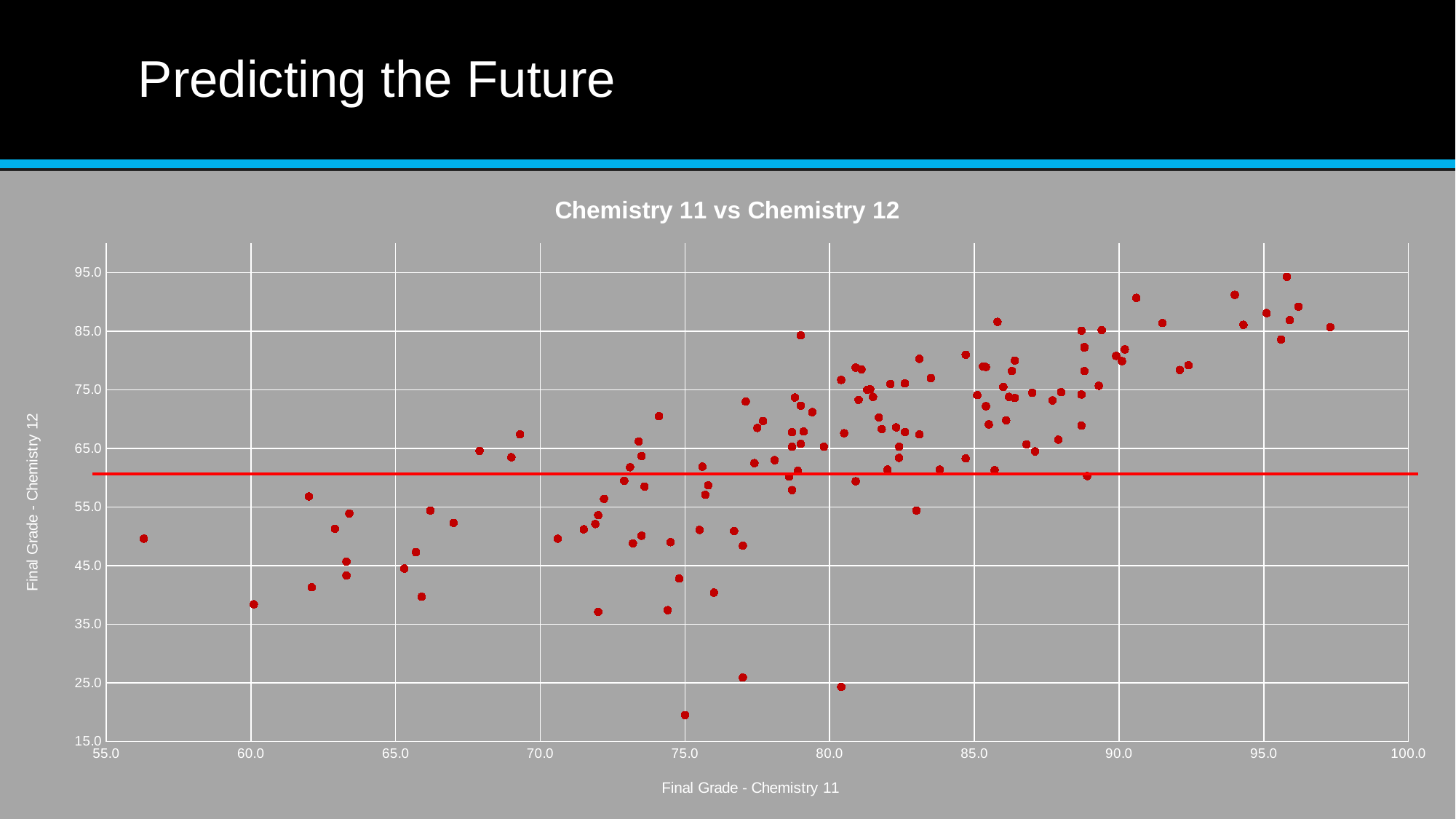
Is the Chemistry 12 grade of the rightmost plotted point greater or less than 75.0? greater Which has the higher Chemistry 12 grade, the leftmost plotted point or the rightmost plotted point? the rightmost plotted point What is the title of the chart? Chemistry 11 vs Chemistry 12 Is the Chemistry 12 grade of the lowest plotted point greater or less than 25.0? less Is the horizontal red line drawn at a Chemistry 12 grade greater or less than 55.0? greater What kind of chart is shown on the slide? scatter chart What is the label of the horizontal axis? Final Grade - Chemistry 11 Do the Chemistry 12 grades generally rise or fall as the Chemistry 11 grade increases along the x axis? rise